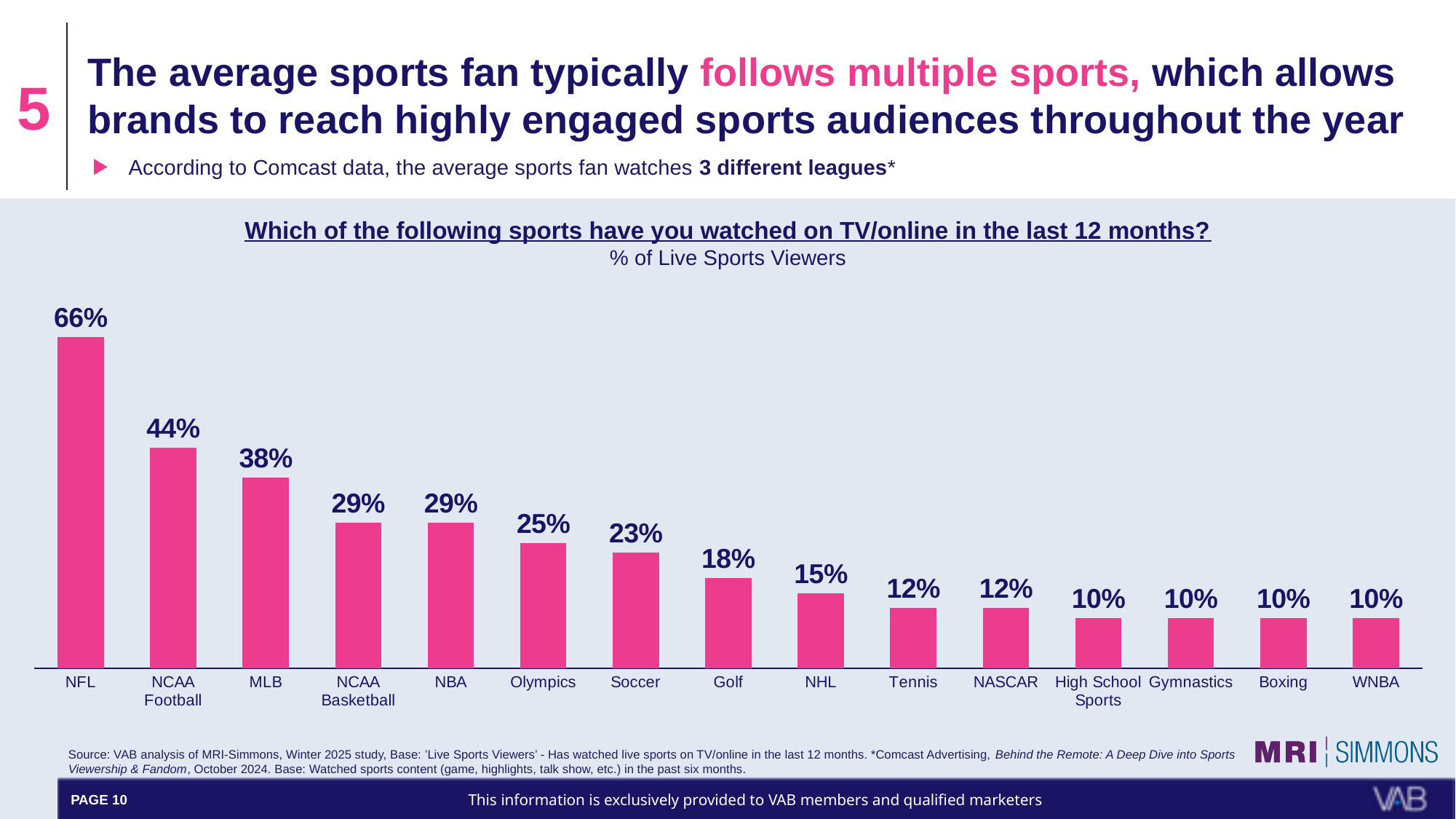
What is the difference between the NFL and NCAA Football percentages? 22% Which has a higher value, NHL or Tennis? NHL What is the difference between the Olympics and Soccer values? 2% What percentage of live sports viewers watched Golf? 18% What kind of chart is shown on the slide? Bar chart What is the subtitle shown under the chart's title question? % of Live Sports Viewers What percentage of live sports viewers watched the NFL in the last 12 months? 66% Which sport has the highest percentage of live sports viewers? NFL How many sports categories are shown in the chart? 15 What is the value shown for MLB? 38% Which has a higher value, NBA or Olympics? NBA Do the values rise or fall moving from left to right along the x axis? Fall